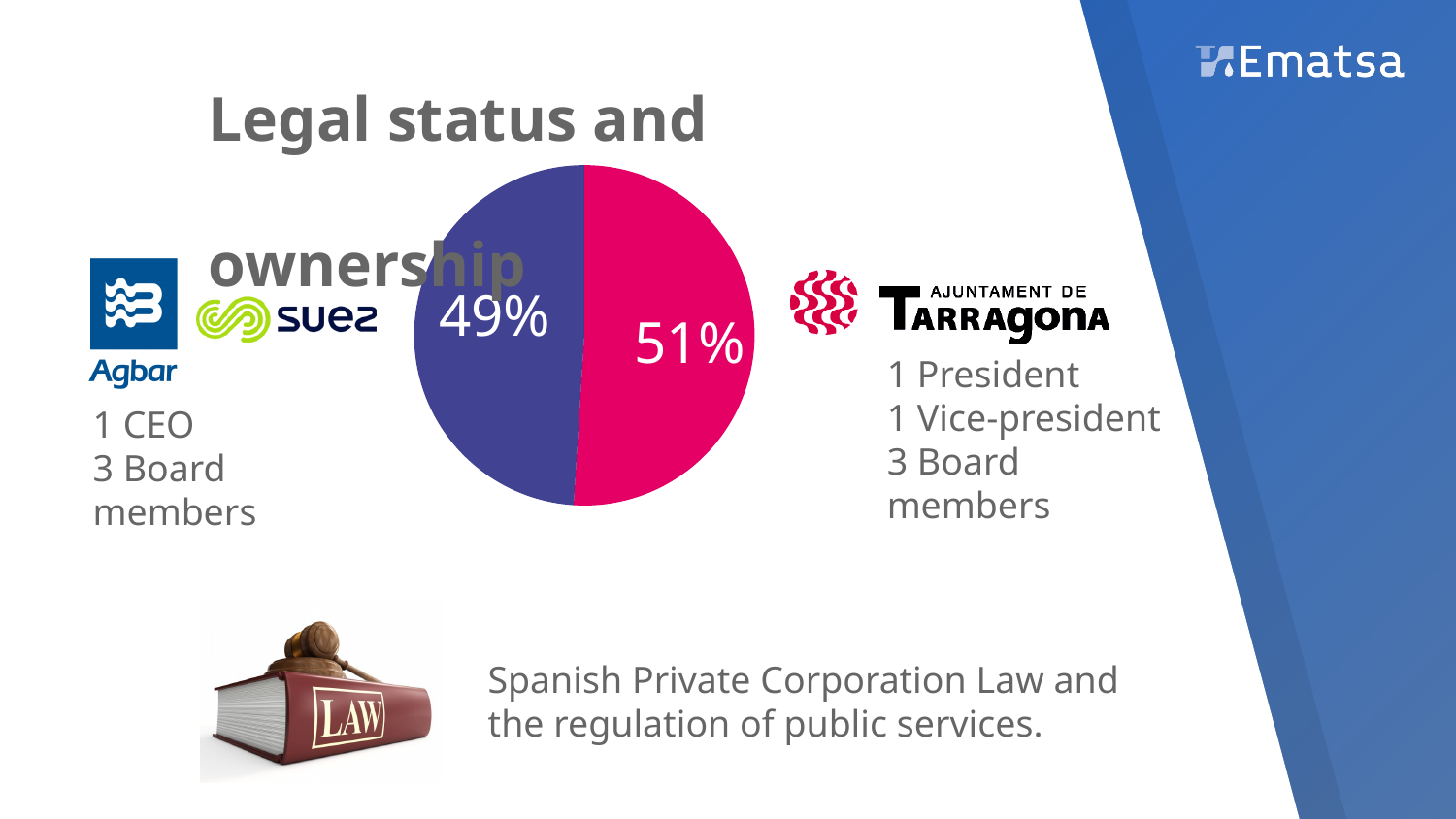
What share of the pie does the slice next to the Ajuntament de Tarragona logo represent? 51% What is the title of the slide containing the pie chart? Legal status and ownership Is the magenta slice of the pie chart larger or smaller than the purple slice? larger Which slice of the pie chart is the smallest? 49% What is the difference between the two slices of the pie chart? 2% What percentage is shown on the magenta slice of the pie chart? 51% What share of the pie does the slice next to the Agbar and Suez logos represent? 49% Is the purple slice of the pie chart greater or less than 50%? less What percentage is shown on the purple slice of the pie chart? 49% Which slice of the pie chart is the largest? 51% How many slices does the pie chart have? 2 What kind of chart is shown on the slide? pie chart